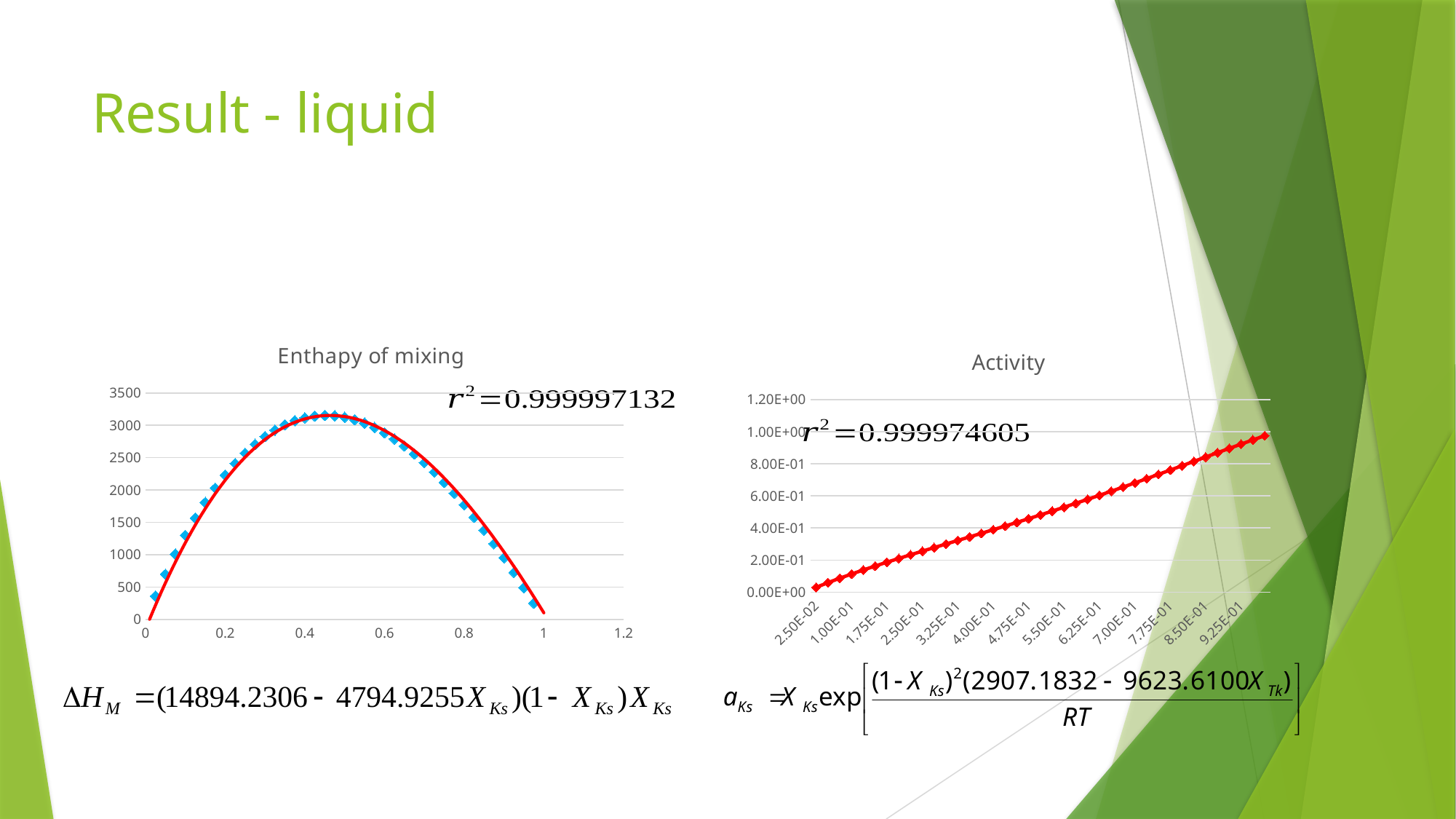
What r² value is shown on the "Activity" chart? 0.999974605 In the "Enthapy of mixing" chart, is the peak value greater or less than 3500? less In the "Enthapy of mixing" chart, is the value at x = 0.8 greater or less than 2000? less In the "Activity" chart, is the value at 9.25E-01 greater or less than 8.00E-01? greater In the "Enthapy of mixing" chart, do the values rise or fall between x = 0.6 and x = 1? fall What r² value is shown on the "Enthapy of mixing" chart? 0.999997132 What kind of chart is the "Enthapy of mixing" chart? scatter chart with a fitted curve What kind of chart is the "Activity" chart? line chart In the "Activity" chart, do the values rise or fall as the x axis increases? rise